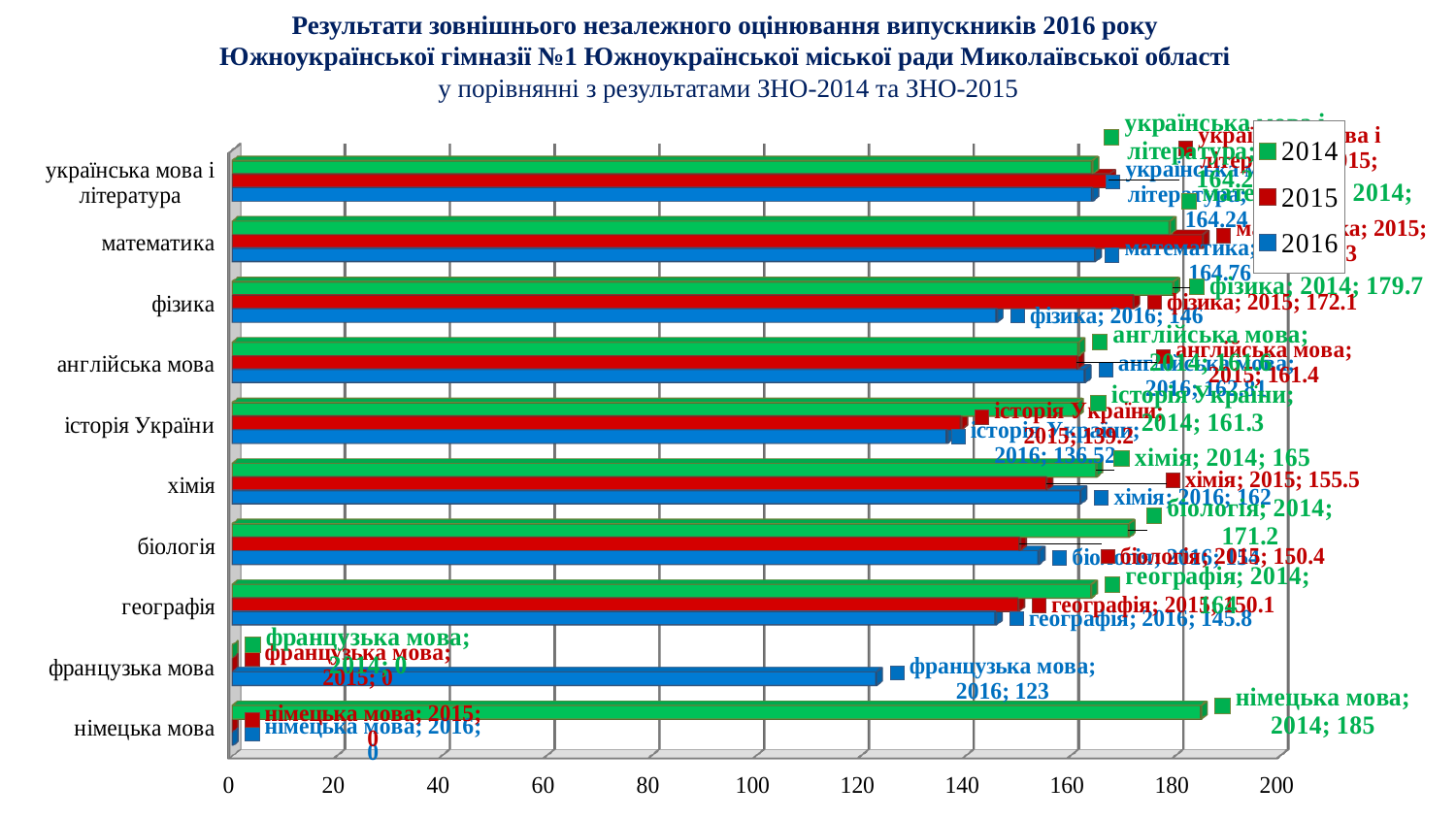
What is the 2014 value for фізика? 179.7 What is the difference between the 2014 and 2015 values for фізика? 7.6 How many subject categories are plotted on the chart? 10 What kind of chart is shown on the slide? bar chart How many series does the legend list? 3 What is the 2015 value for хімія? 155.5 What is the 2016 value for французька мова? 123 Which subject has the highest 2014 value? німецька мова What is the 2014 value for німецька мова? 185 Is the 2014 value for математика greater or less than 160? greater Which is larger for історія України: the 2014 value or the 2015 value? 2014 What is the 2016 value for історія України? 136.52